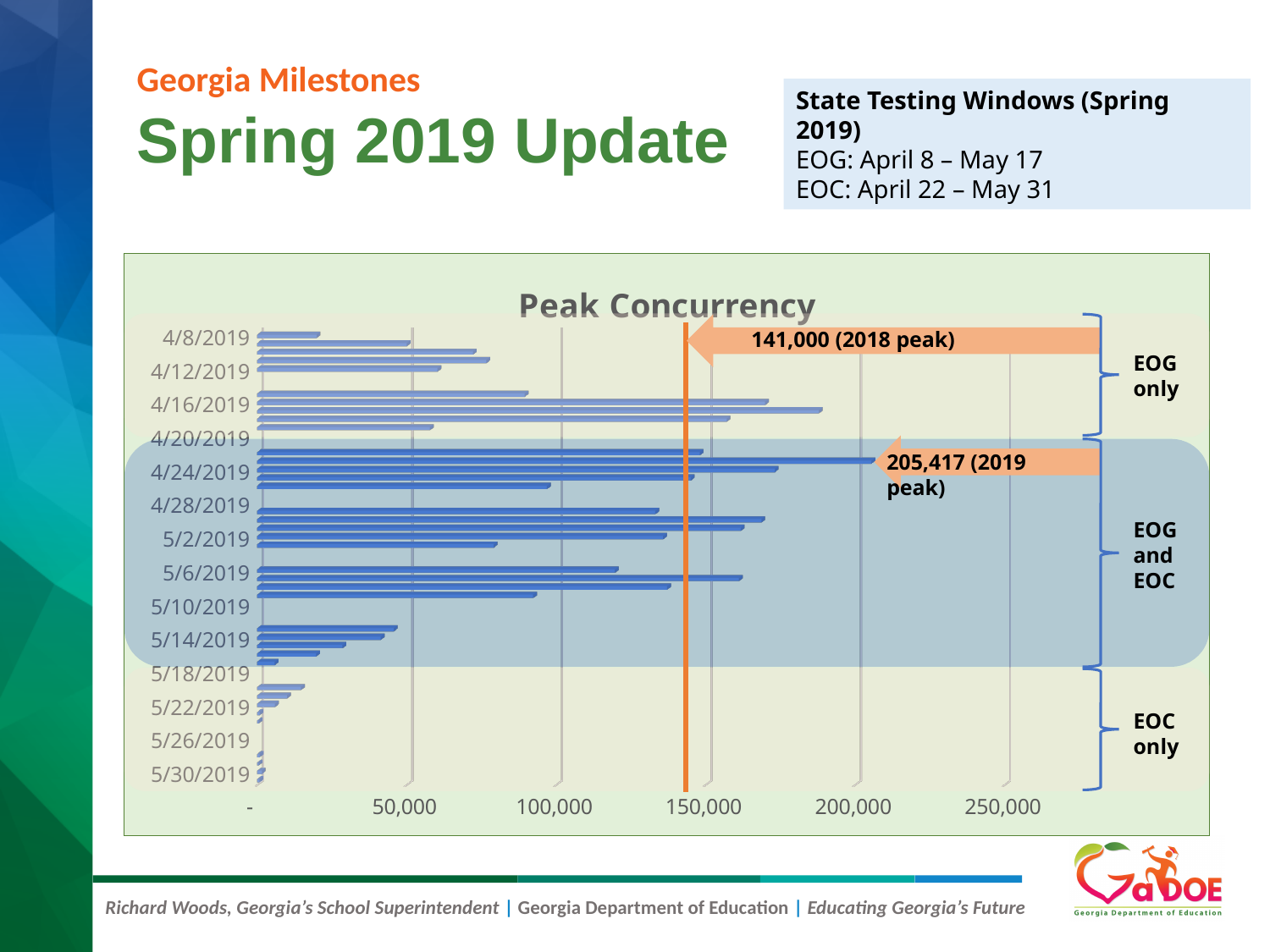
By how much does the 2019 peak (205,417) exceed the 2018 peak (141,000)? 64,417 What is the title of the chart? Peak Concurrency Is the value for 4/24/2019 greater or less than 150,000? greater Which has the larger value, 4/16/2019 or 4/8/2019? 4/16/2019 Is the value for 4/8/2019 greater or less than 50,000? less Is the value for 5/6/2019 greater or less than 100,000? greater Which has the larger value, 4/24/2019 or 5/14/2019? 4/24/2019 What was the 2019 peak concurrency value annotated on the chart? 205,417 What was the 2018 peak concurrency value annotated on the chart? 141,000 How many testing-window groups are bracketed on the right side of the chart? 3 What type of chart is shown on the slide? bar chart